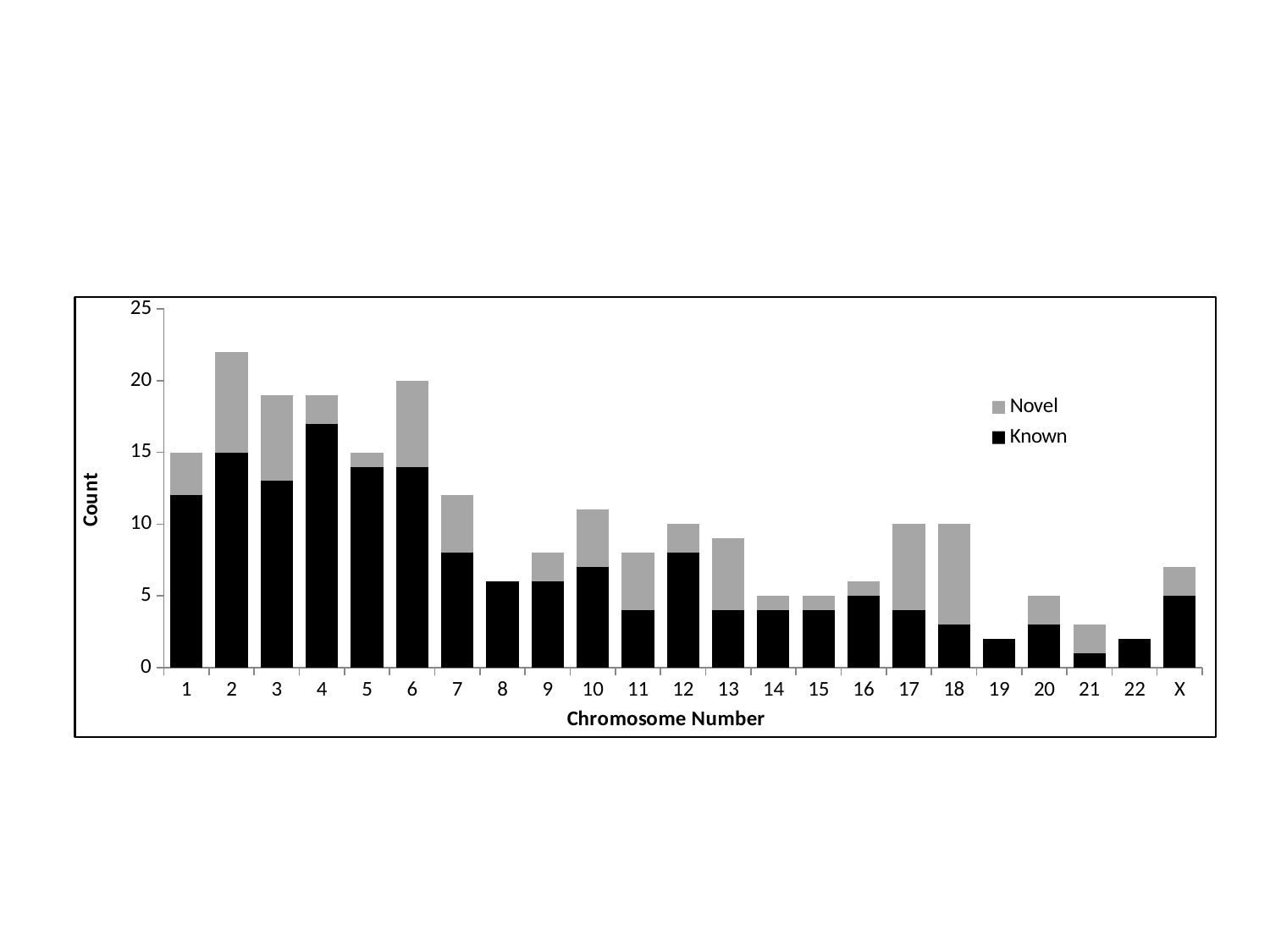
What kind of chart is shown on the slide? Stacked bar chart Which chromosome has the highest total count? 2 What is the Known count for chromosome 2? 15 What is the title of the x axis? Chromosome Number How many chromosome categories are shown on the x axis? 23 How many series does the legend list? 2 Which has the larger total count, chromosome 1 or chromosome 7? Chromosome 1 Is the total count for chromosome 3 greater or less than 20? less Which chromosome has the highest Known count? 4 Is the Known count for chromosome 4 greater or less than 15? greater What are the two series named in the legend? Novel and Known What is the total count for chromosome 6? 20